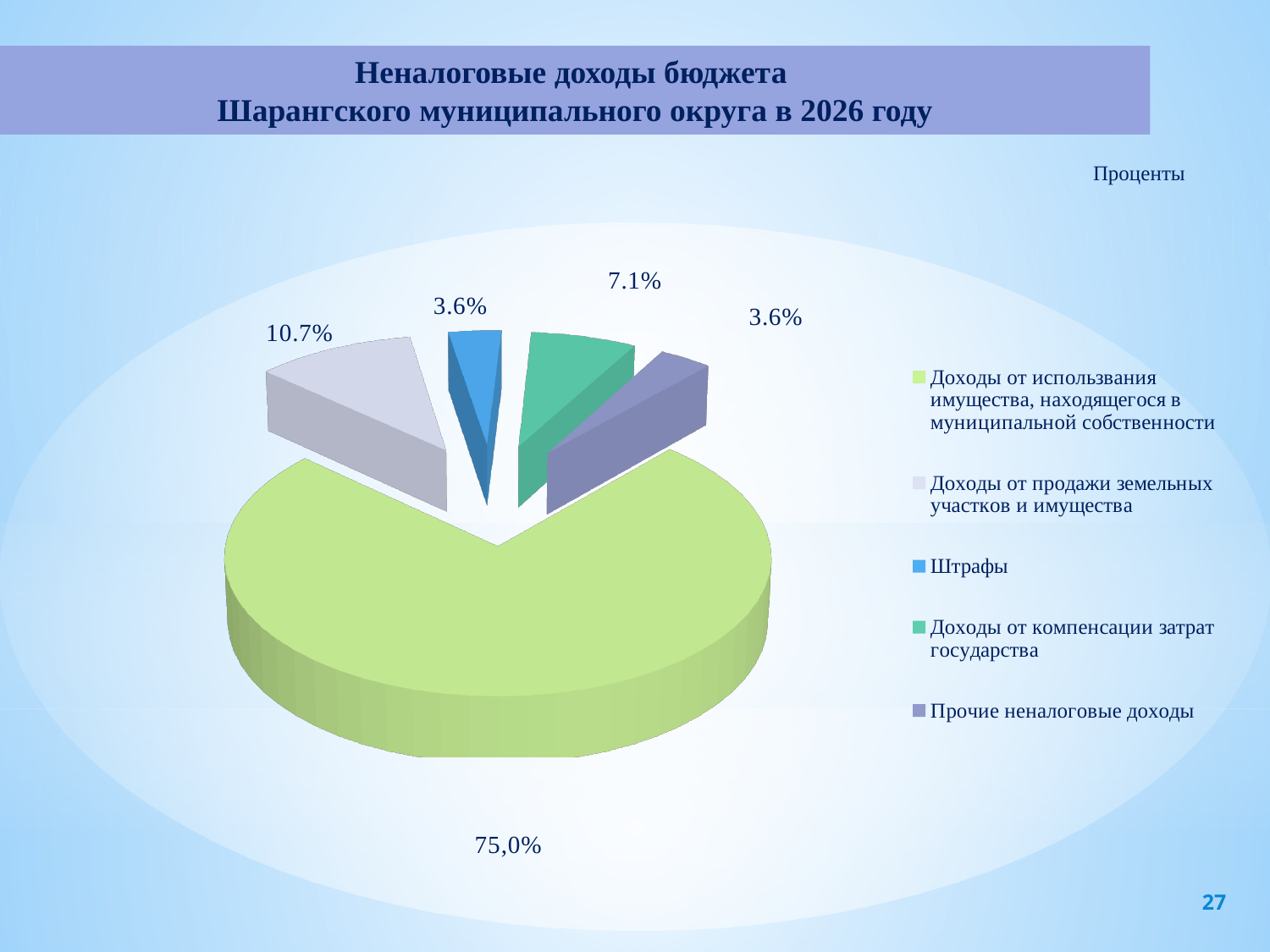
What kind of chart is shown on the slide? pie chart Which category has the largest share of the pie? Доходы от использования имущества, находящегося в муниципальной собственности What share of the pie is labelled for "Доходы от использования имущества, находящегося в муниципальной собственности"? 75,0% What share of the pie is labelled for "Прочие неналоговые доходы"? 3.6% How many slices does the pie chart have? 5 What share of the pie is labelled for "Штрафы"? 3.6% Which is larger: the share for "Доходы от продажи земельных участков и имущества" or the share for "Доходы от компенсации затрат государства"? Доходы от продажи земельных участков и имущества What is the difference in percentage points between the share for "Доходы от продажи земельных участков и имущества" and the share for "Доходы от компенсации затрат государства"? 3.6 How many entries does the legend list? 5 What share of the pie is labelled for "Доходы от компенсации затрат государства"? 7.1% What share of the pie is labelled for "Доходы от продажи земельных участков и имущества"? 10.7% What is the title of the chart on the slide? Неналоговые доходы бюджета Шарангского муниципального округа в 2026 году